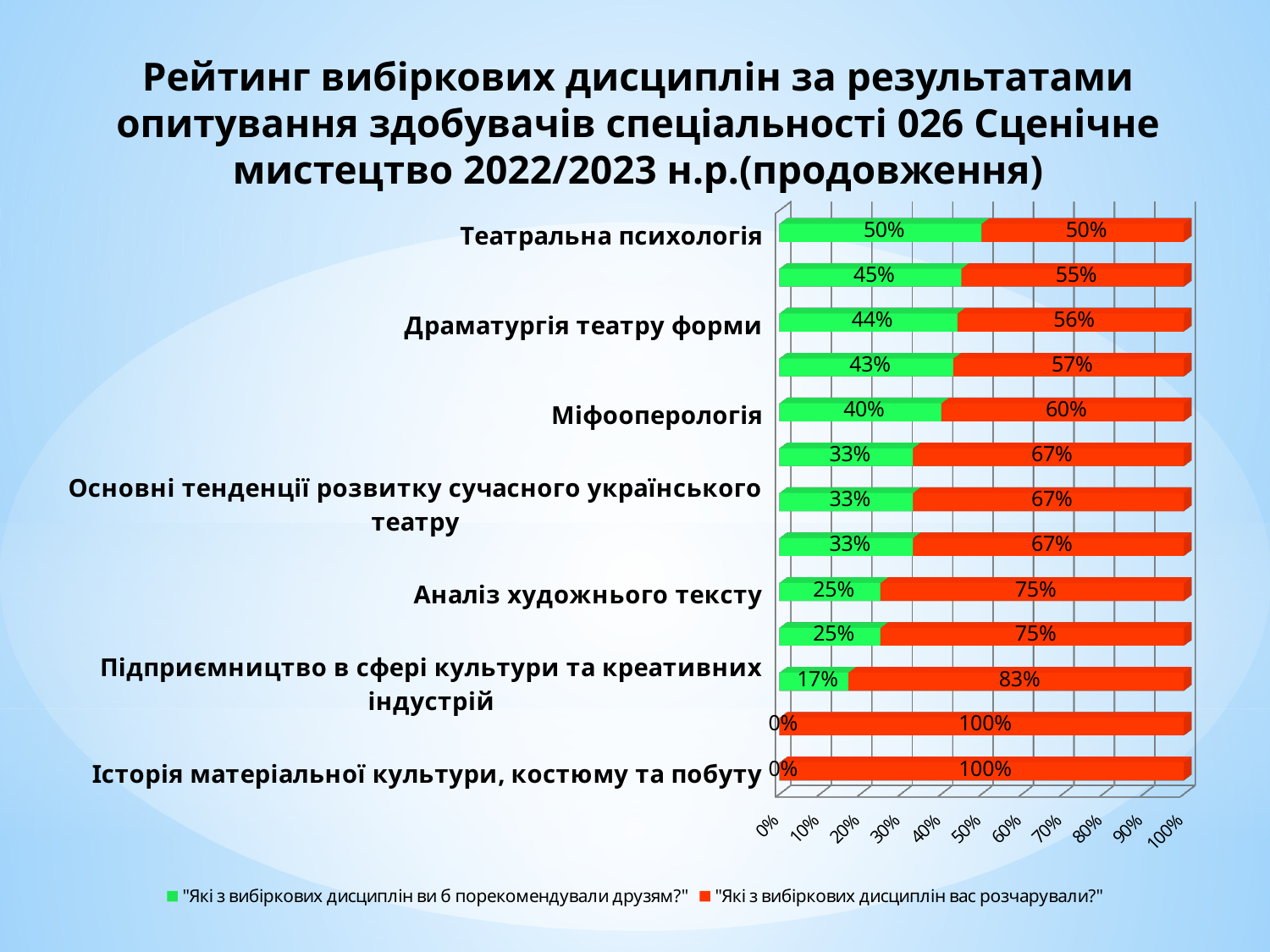
How many bars are plotted in the chart? 13 What is the green ("порекомендували друзям") value for Театральна психологія? 50% What is the difference between the red and green values for Міфооперологія? 20% Which labelled discipline has the highest green ("порекомендували друзям") value? Театральна психологія What is the red value for Аналіз художнього тексту? 75% What is the red ("розчарували") value for Драматургія театру форми? 56% What kind of chart is shown on the slide? Stacked bar chart What is the red value for Історія матеріальної культури, костюму та побуту? 100% Which is larger for Аналіз художнього тексту: the green value or the red value? The red value How many series does the legend list? 2 What is the green value for Міфооперологія? 40% What is the green value for Підприємництво в сфері культури та креативних індустрій? 17%